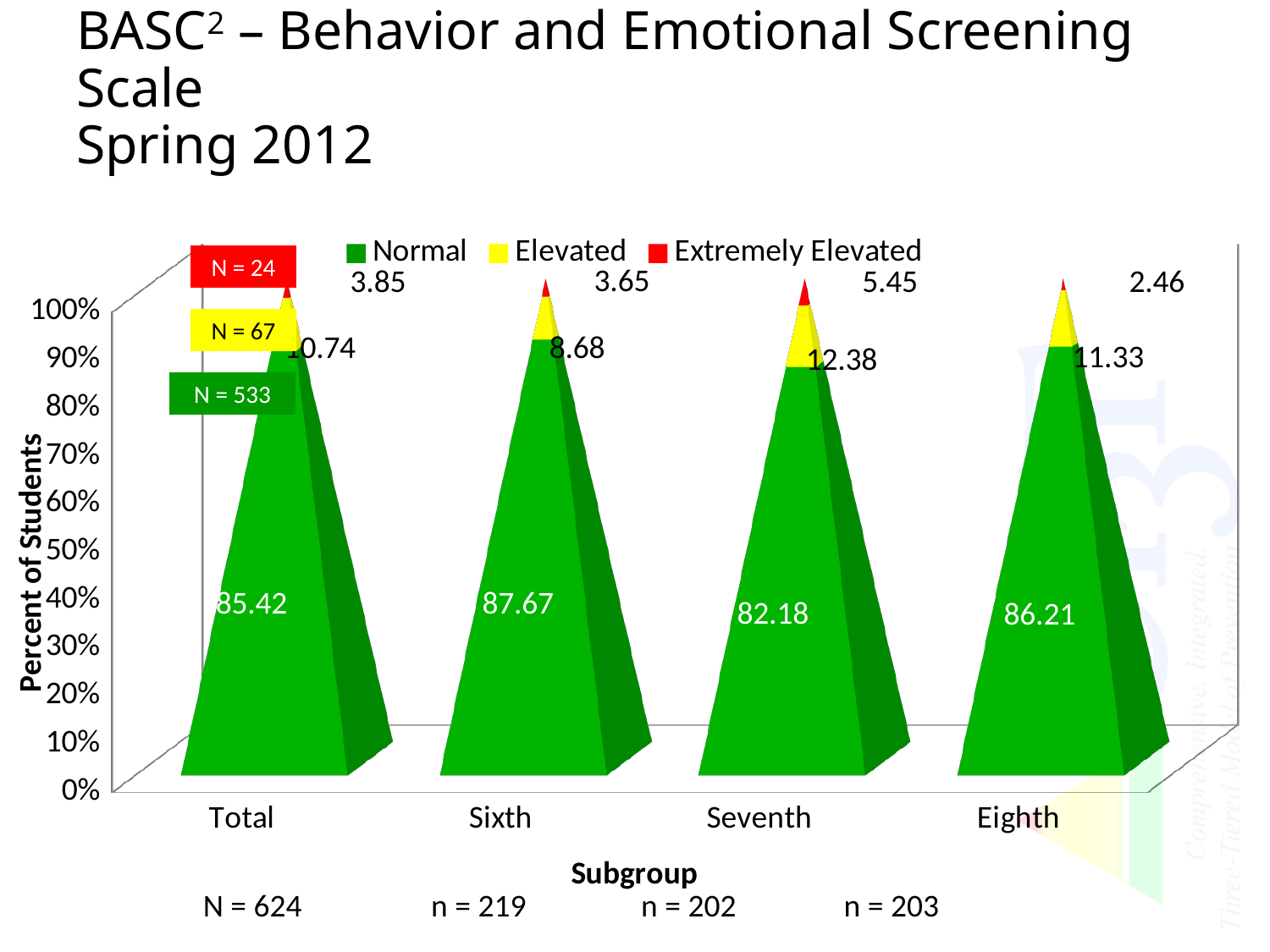
What is the Normal value for the Seventh subgroup? 82.18 How many series does the legend list? 3 How many subgroups are shown on the x axis? 4 Which subgroup has the lowest Normal value? Seventh What is the Extremely Elevated value for the Eighth subgroup? 2.46 What is the Elevated value for the Sixth subgroup? 8.68 Which subgroup has the larger Elevated value, Seventh or Eighth? Seventh What is the title of the vertical axis? Percent of Students Which subgroup has the highest Extremely Elevated value? Seventh What is the difference between the Normal values for Sixth and Seventh? 5.49 What is the Normal value for the Total subgroup? 85.42 Which subgroup has the highest Normal value? Sixth